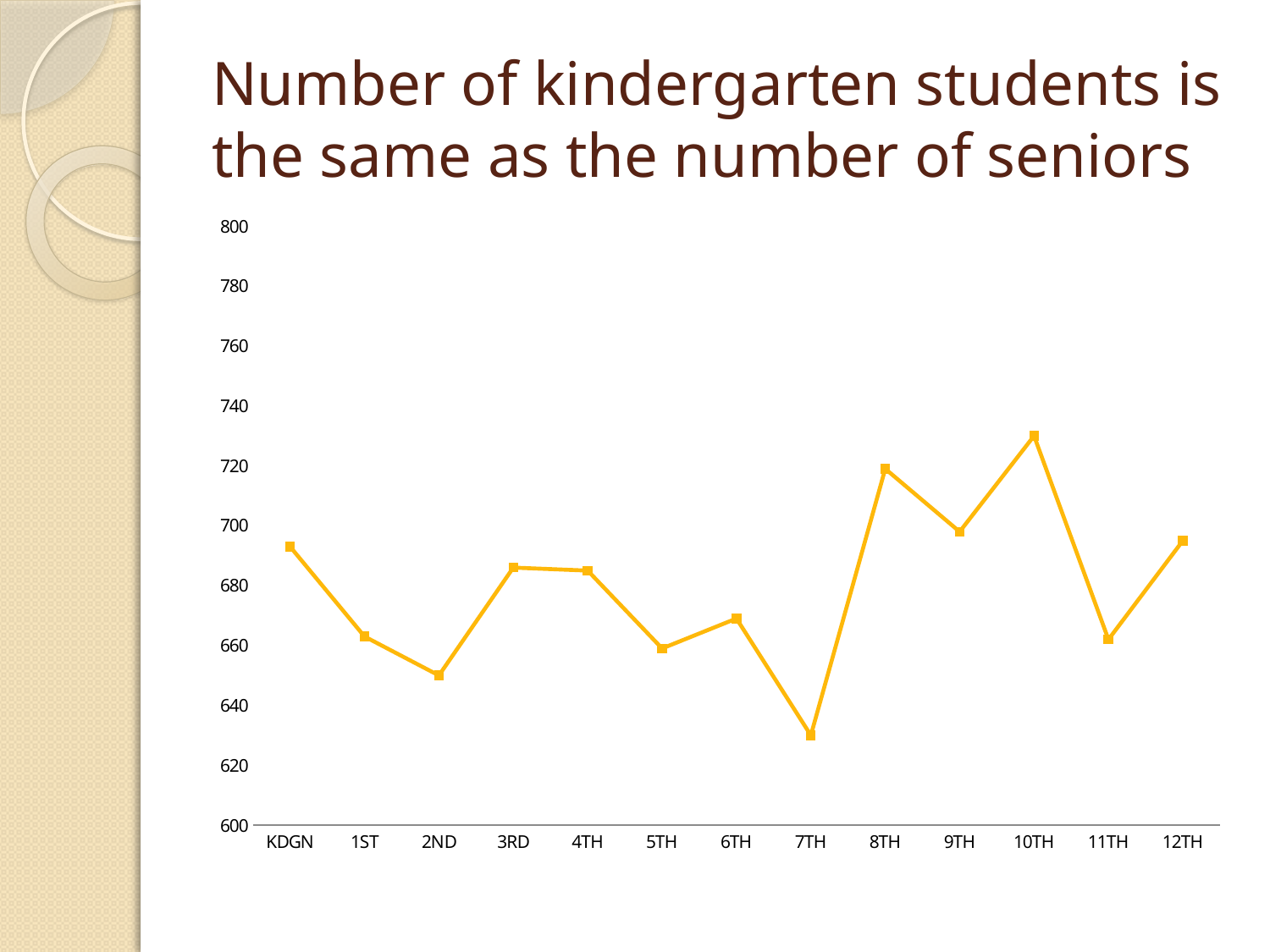
What is the title of the slide containing the chart? Number of kindergarten students is the same as the number of seniors What kind of chart is shown on the slide? line chart Is the value for 8TH greater or less than 700? greater Which grade level has the lowest value? 7TH Is the value for 10TH greater or less than 720? greater How many grade levels are plotted along the x axis? 13 Do the values rise or fall from KDGN to 2ND? fall Which is larger, the value for 8TH or the value for 7TH? 8TH Is the value for 2ND greater or less than 660? less Which is larger, the value for 2ND or the value for 3RD? 3RD Which grade level has the highest value? 10TH